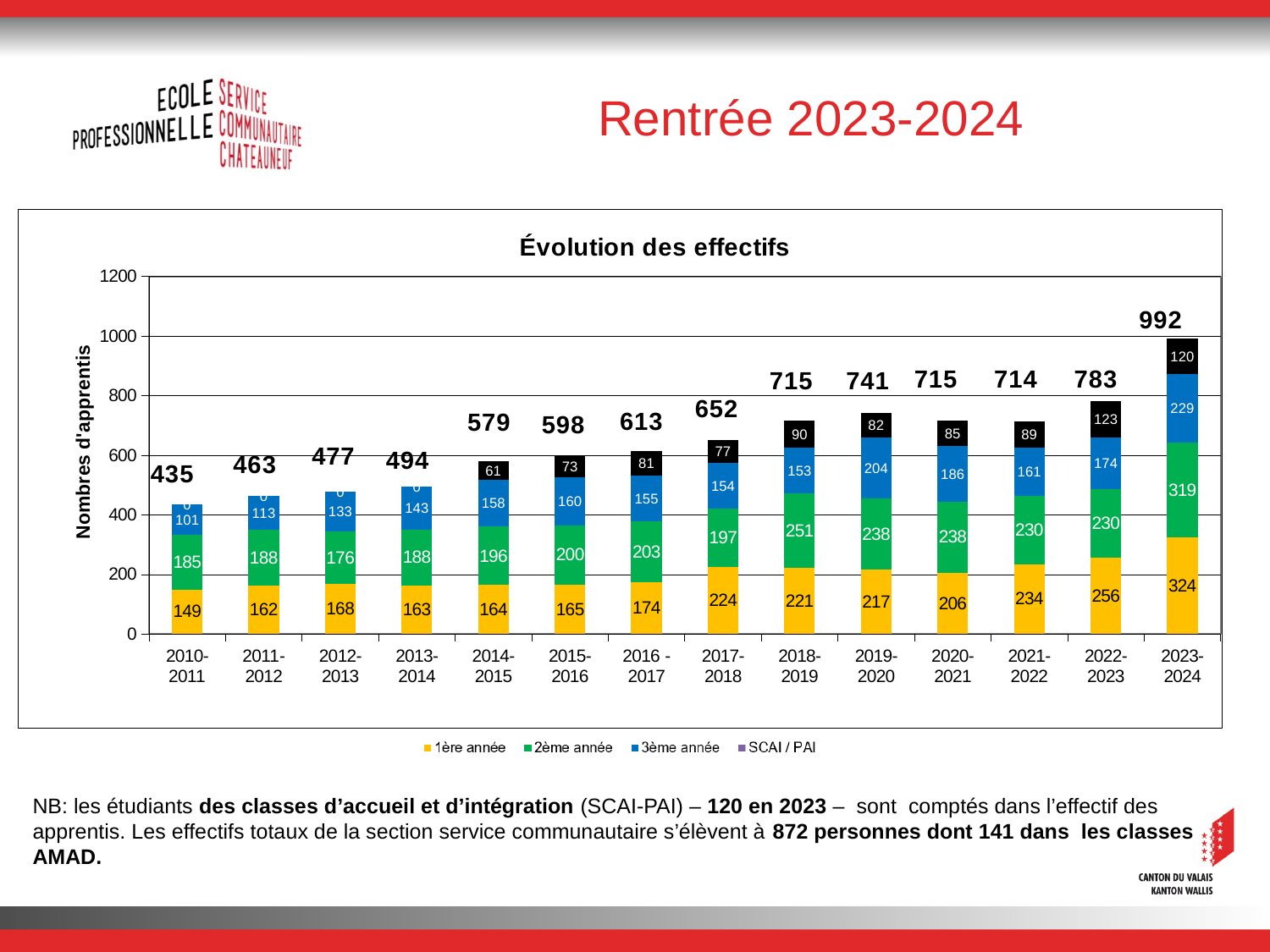
What type of chart is shown on the slide? Stacked bar chart What is the difference between the totals for 2023-2024 and 2022-2023? 209 Is the total for 2019-2020 greater or less than 800? less Which school year has the highest total number of apprentices? 2023-2024 What is the value of the 1ère année series for 2023-2024? 324 How many school years (categories) are shown on the x axis? 14 Which is larger: the 1ère année value for 2023-2024 or for 2022-2023? 2023-2024 Which school year has the lowest total number of apprentices? 2010-2011 What is the total number of apprentices for 2023-2024? 992 What is the SCAI / PAI value for 2022-2023? 123 What is the title of the chart? Évolution des effectifs How many series does the legend list? 4